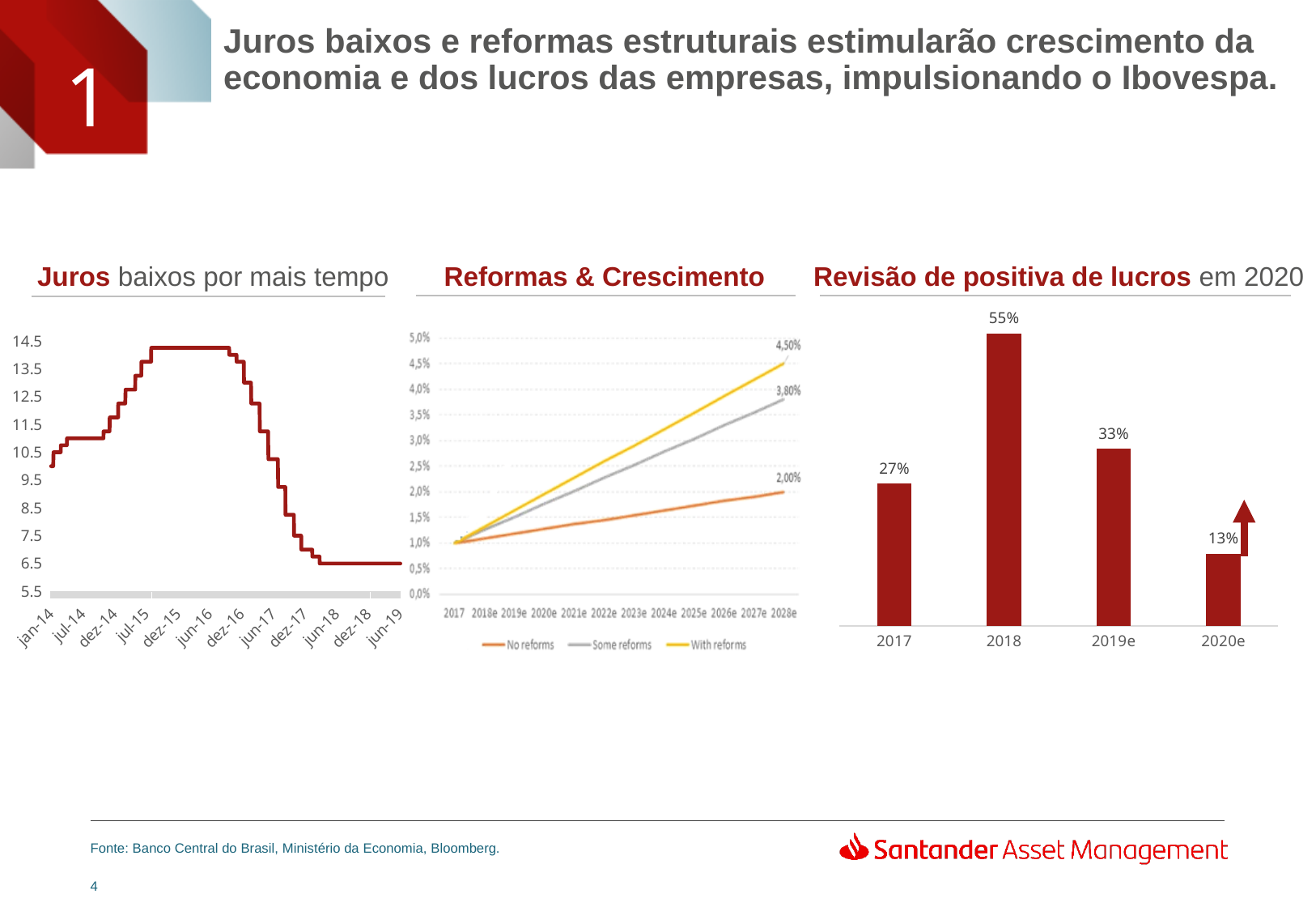
In the 'Juros baixos por mais tempo' chart, is the value at jun-19 greater or less than 8.5? less In the 'Reformas & Crescimento' chart, what value does the 'With reforms' line reach in 2028e? 4,50% In the 'Revisão de positiva de lucros em 2020' chart, what is the value for 2018? 55% In the 'Revisão de positiva de lucros em 2020' chart, which year has the lowest value? 2020e In the 'Reformas & Crescimento' chart, which series is higher in 2028e, 'Some reforms' or 'No reforms'? Some reforms In the 'Revisão de positiva de lucros em 2020' chart, how many bars are shown? 4 In the 'Revisão de positiva de lucros em 2020' chart, what is the value for 2020e? 13% How many series does the legend of the 'Reformas & Crescimento' chart list? 3 What kind of chart is 'Revisão de positiva de lucros em 2020'? Bar chart In the 'Reformas & Crescimento' chart, what value does the 'No reforms' line reach in 2028e? 2,00% In the 'Revisão de positiva de lucros em 2020' chart, what is the difference between the values for 2018 and 2019e? 22% In the 'Revisão de positiva de lucros em 2020' chart, which year has the highest value? 2018